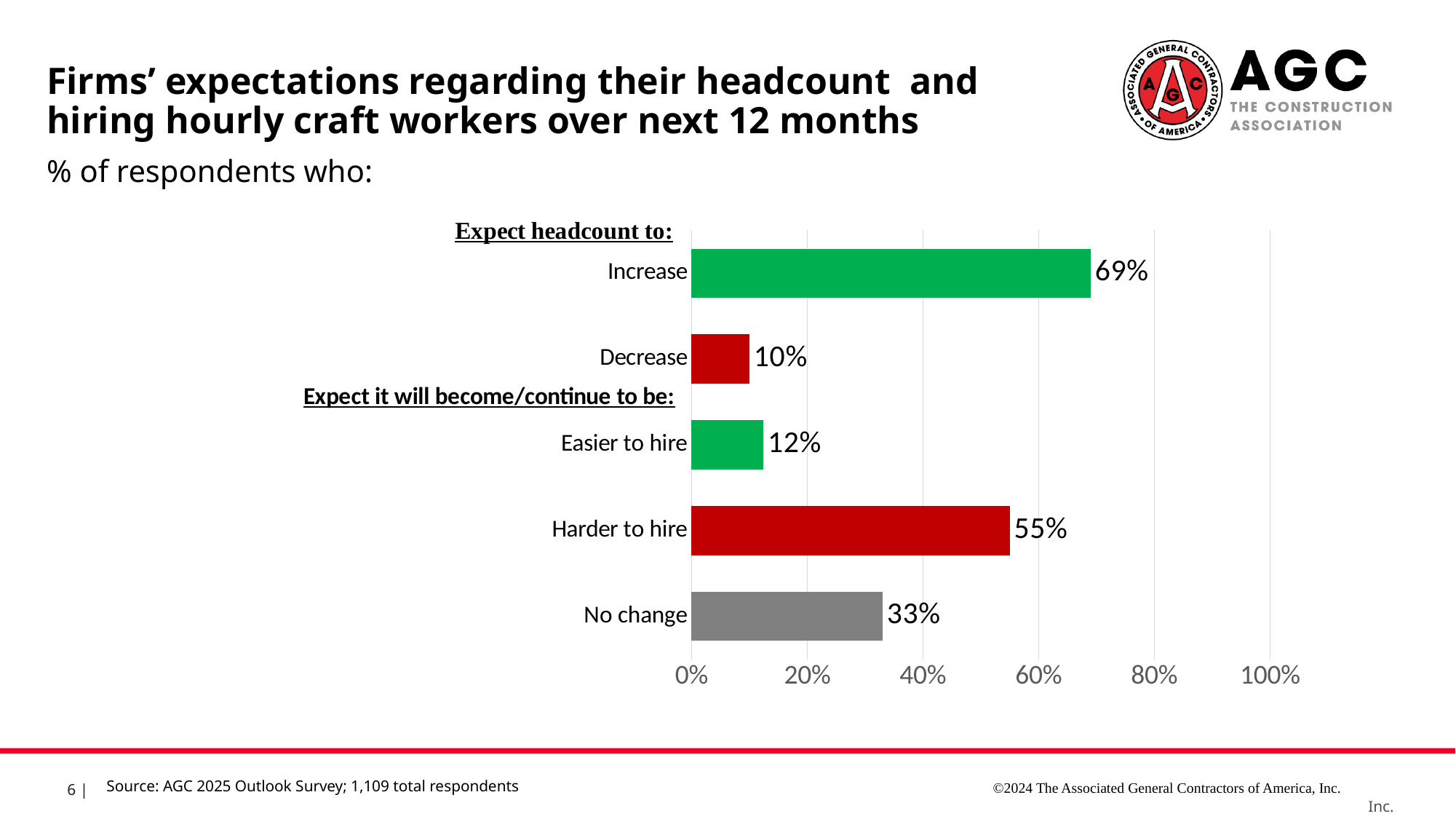
What percentage of respondents expect it will become or continue to be harder to hire? 55% What colour is the bar for Harder to hire? Red What kind of chart is shown on the slide? Bar chart What percentage of respondents expect headcount to increase? 69% Which category has the highest value in the chart? Increase Which category has the lowest value in the chart? Decrease What percentage of respondents expect headcount to decrease? 10% What is the difference between the percentage expecting it to be harder to hire and the percentage expecting it to be easier to hire? 43% Which is larger: the percentage expecting headcount to increase or the percentage expecting it to be harder to hire? Increase What percentage of respondents expect no change in hiring difficulty? 33% How many categories are plotted in the chart? 5 Is the value for No change greater or less than 40%? less